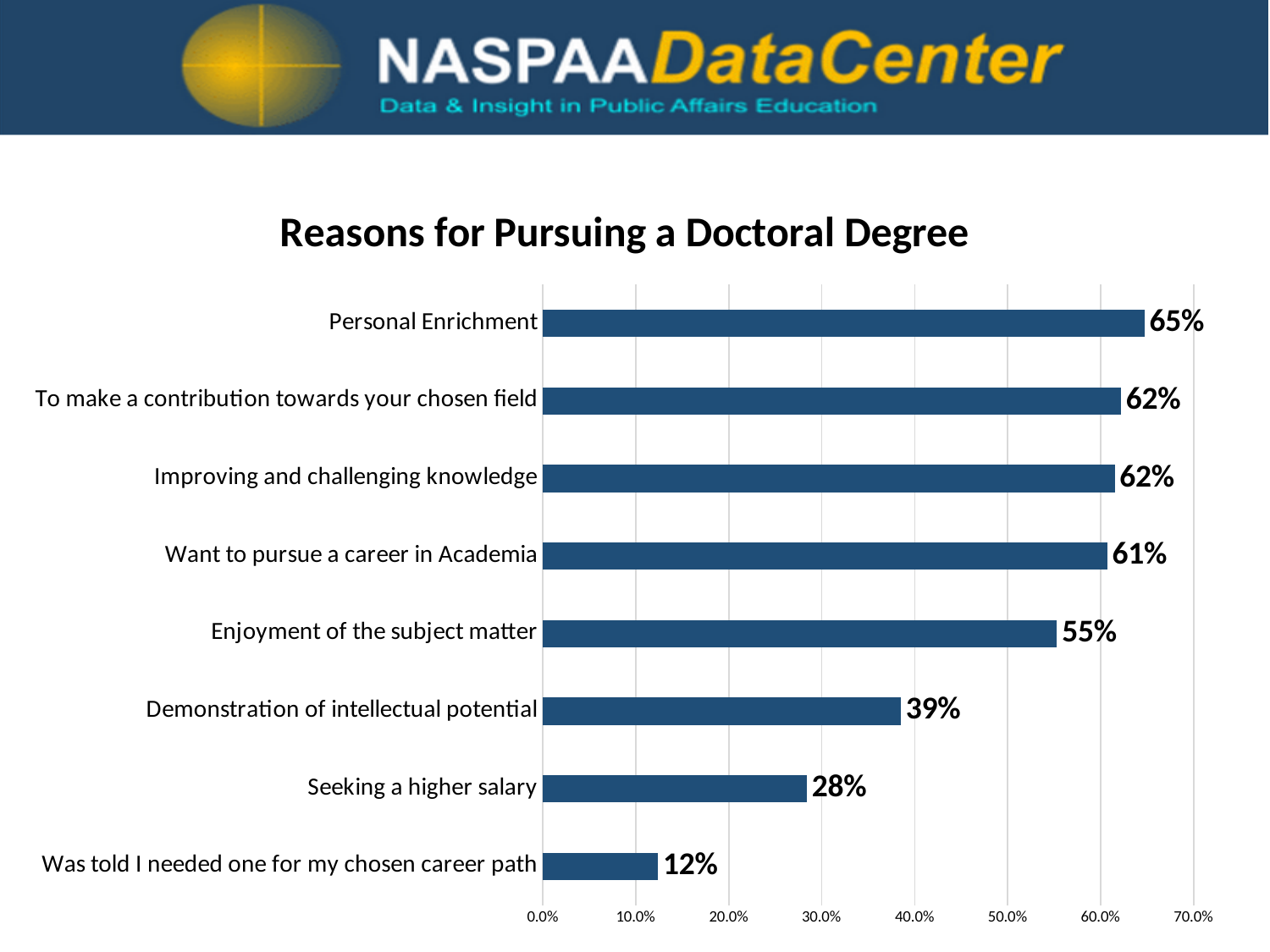
What is the value for Seeking a higher salary? 28% What is the value for Was told I needed one for my chosen career path? 12% What is the value for Demonstration of intellectual potential? 39% What is the title of the chart? Reasons for Pursuing a Doctoral Degree What is the difference between Personal Enrichment and Seeking a higher salary? 37% How many reasons are shown in the chart? 8 Which reason has the lowest value? Was told I needed one for my chosen career path What is the value for Personal Enrichment? 65% Which reason has the highest value? Personal Enrichment What kind of chart is shown? Bar chart Is the value for Want to pursue a career in Academia greater or less than 50.0%? greater Which is larger: Enjoyment of the subject matter or Demonstration of intellectual potential? Enjoyment of the subject matter